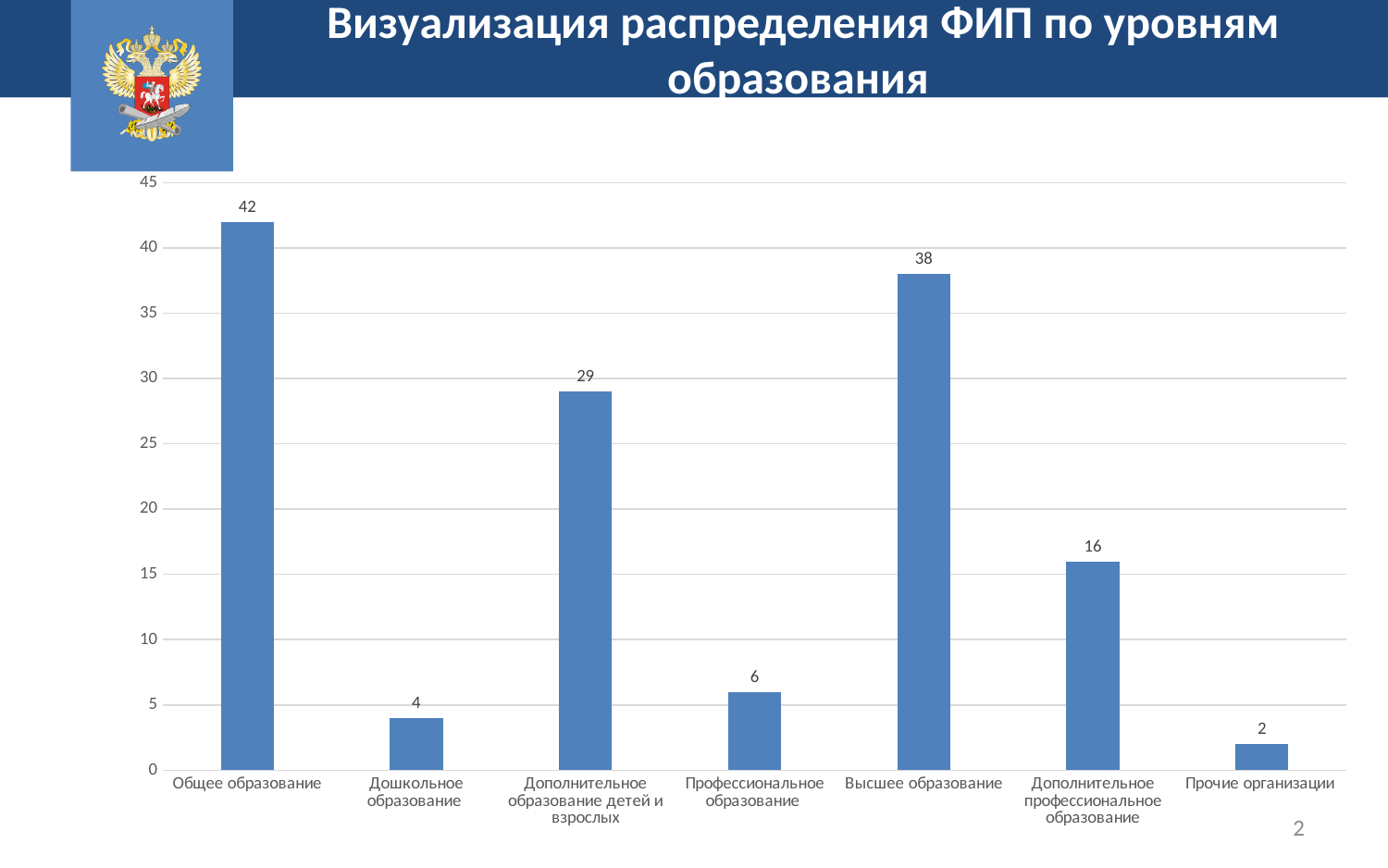
What is the value for Общее образование? 42 How many categories are shown on the x axis? 7 Which category has the lowest value? Прочие организации What is the title of the slide? Визуализация распределения ФИП по уровням образования What is the value for Дополнительное профессиональное образование? 16 What is the value for Прочие организации? 2 What is the value for Высшее образование? 38 Which is larger: the value for Дошкольное образование or the value for Профессиональное образование? Профессиональное образование What is the difference between the values for Общее образование and Высшее образование? 4 Which category has the highest value? Общее образование Is the value for Дополнительное образование детей и взрослых greater or less than 25? greater What kind of chart is shown on the slide? bar chart